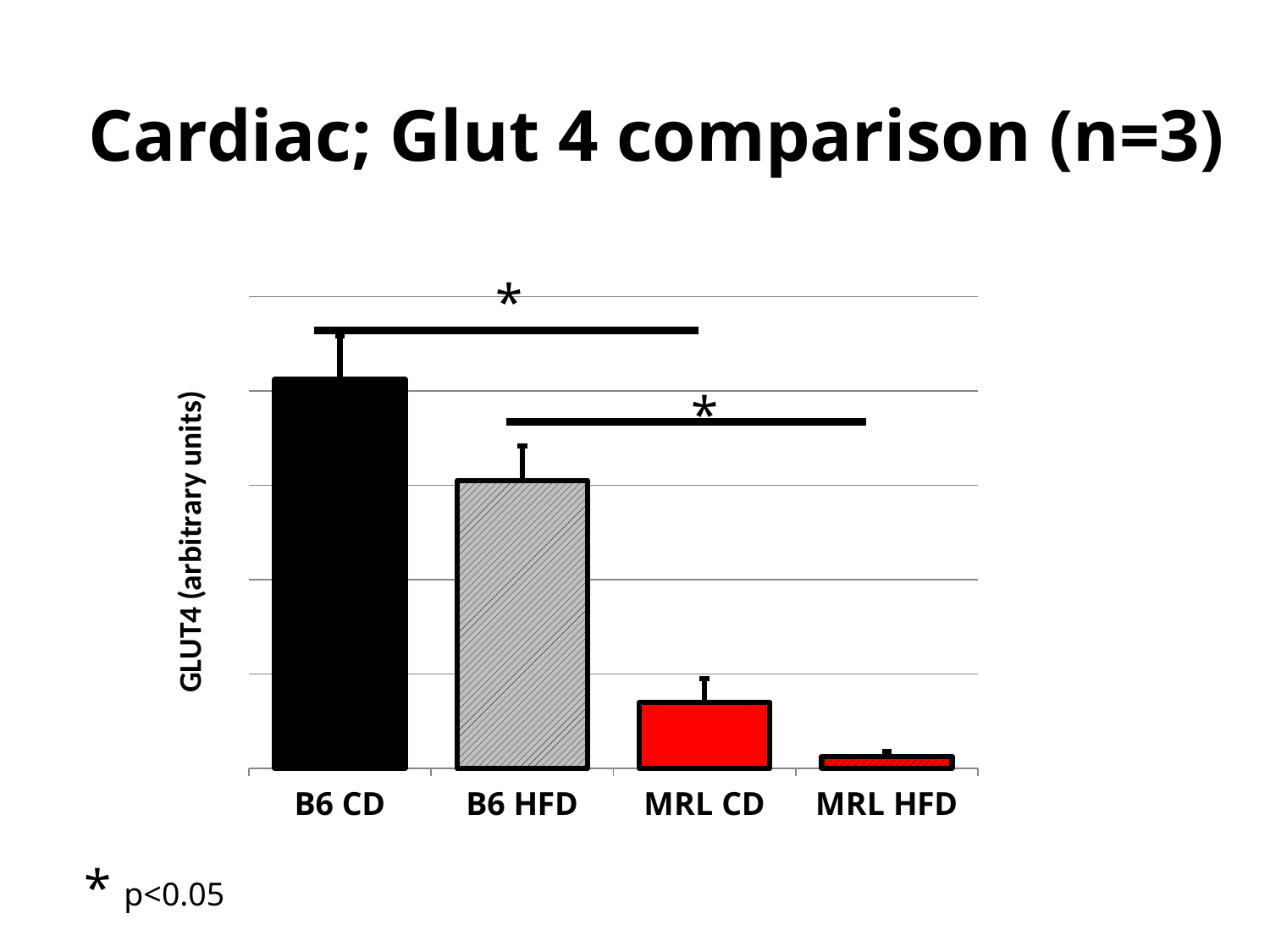
Which category has the lowest GLUT4 value? MRL HFD What kind of chart is shown on the slide? bar chart Do the bar values rise or fall from left to right along the x axis? fall How many categories are plotted on the x axis? 4 What is the label of the y axis? GLUT4 (arbitrary units) Which is larger, the value for B6 CD or the value for B6 HFD? B6 CD Which is larger, the value for MRL CD or the value for MRL HFD? MRL CD Which category has the highest GLUT4 value? B6 CD What is the title of the slide? Cardiac; Glut 4 comparison (n=3) Which is larger, the value for B6 HFD or the value for MRL CD? B6 HFD